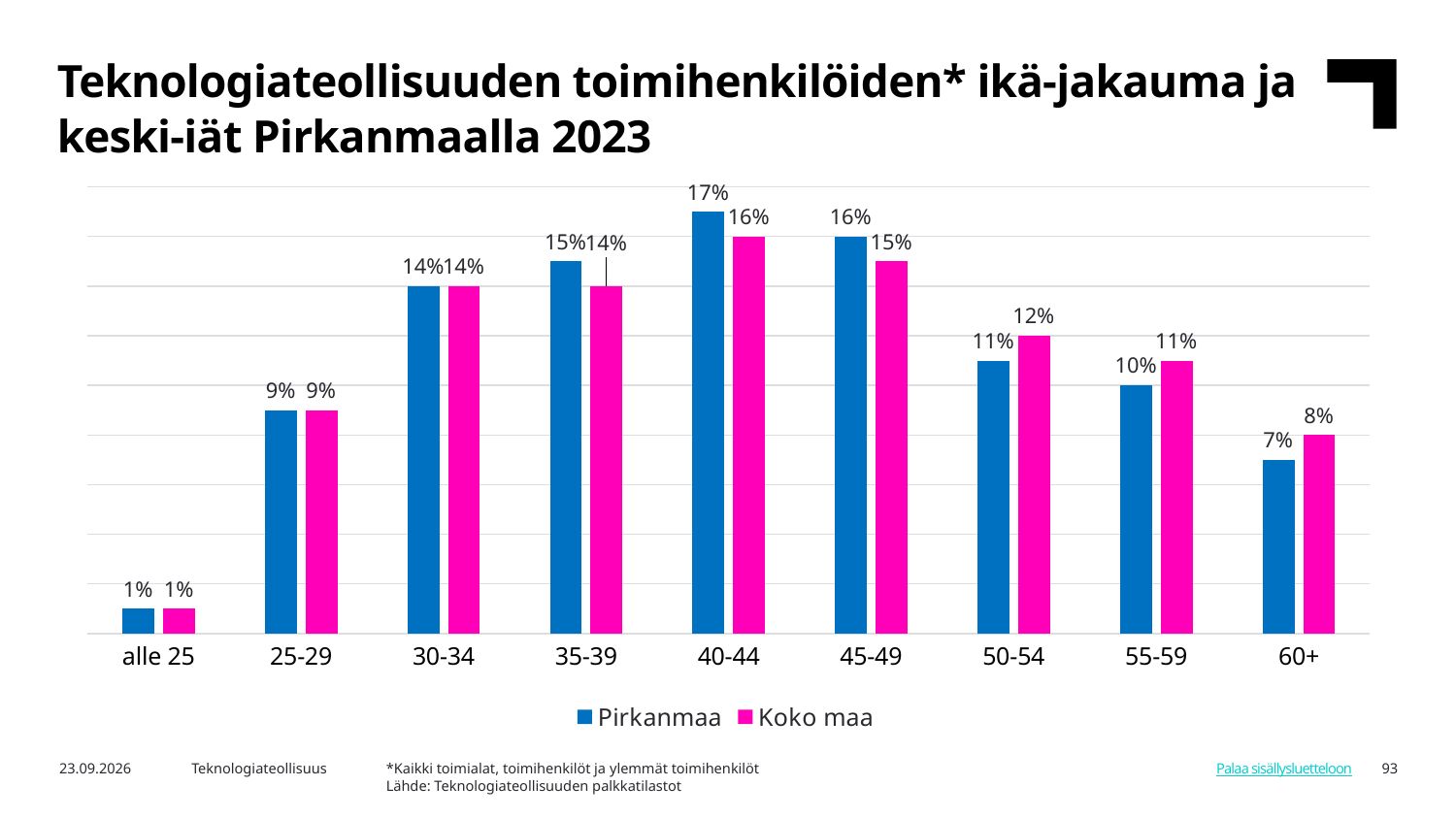
What is the difference between the Pirkanmaa values for 40-44 and 60+? 10% Which age group has the highest value for Pirkanmaa? 40-44 How many series does the legend list? 2 What kind of chart is shown on the slide? Bar chart What is the value for Pirkanmaa in the 60+ age group? 7% How many age groups are shown on the x axis? 9 In the 55-59 age group, which series has the larger value, Pirkanmaa or Koko maa? Koko maa What is the value for Koko maa in the 50-54 age group? 12% Which colour represents the Koko maa series? Pink What is the value for Pirkanmaa in the 40-44 age group? 17% What is the difference between the Pirkanmaa and Koko maa values in the 45-49 age group? 1% Which age group has the lowest value for Koko maa? alle 25